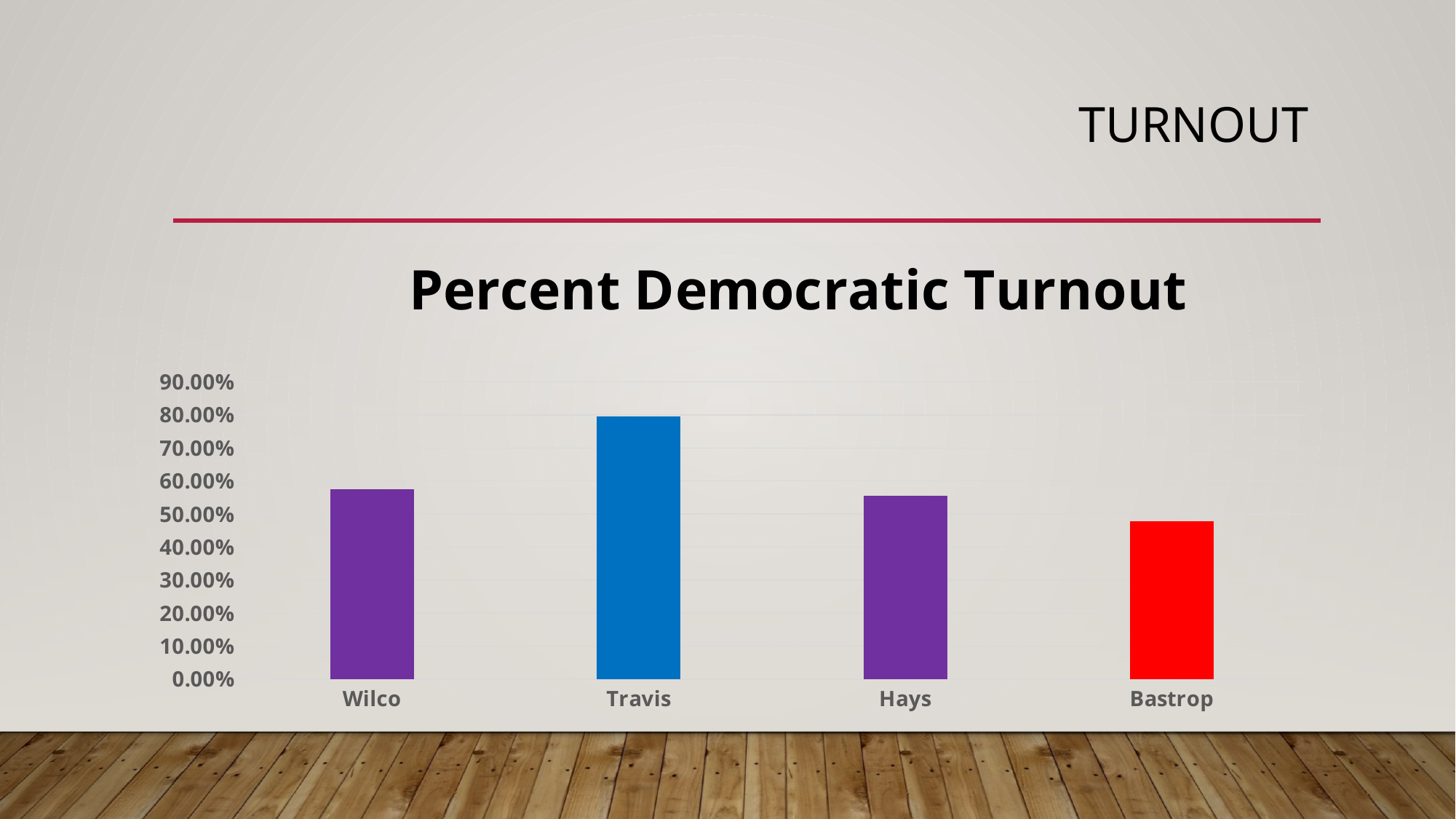
What colour is the bar for Bastrop? red How many counties are shown on the chart? 4 Is the value for Hays greater or less than 60.00%? less Is the value for Bastrop greater or less than 50.00%? less What is the title of the chart? Percent Democratic Turnout Is the value for Wilco greater or less than 50.00%? greater What kind of chart is shown on the slide? bar chart Which county has the highest percent Democratic turnout? Travis Which county has the lowest percent Democratic turnout? Bastrop Which has a higher percent Democratic turnout, Travis or Hays? Travis Which has a higher percent Democratic turnout, Wilco or Bastrop? Wilco